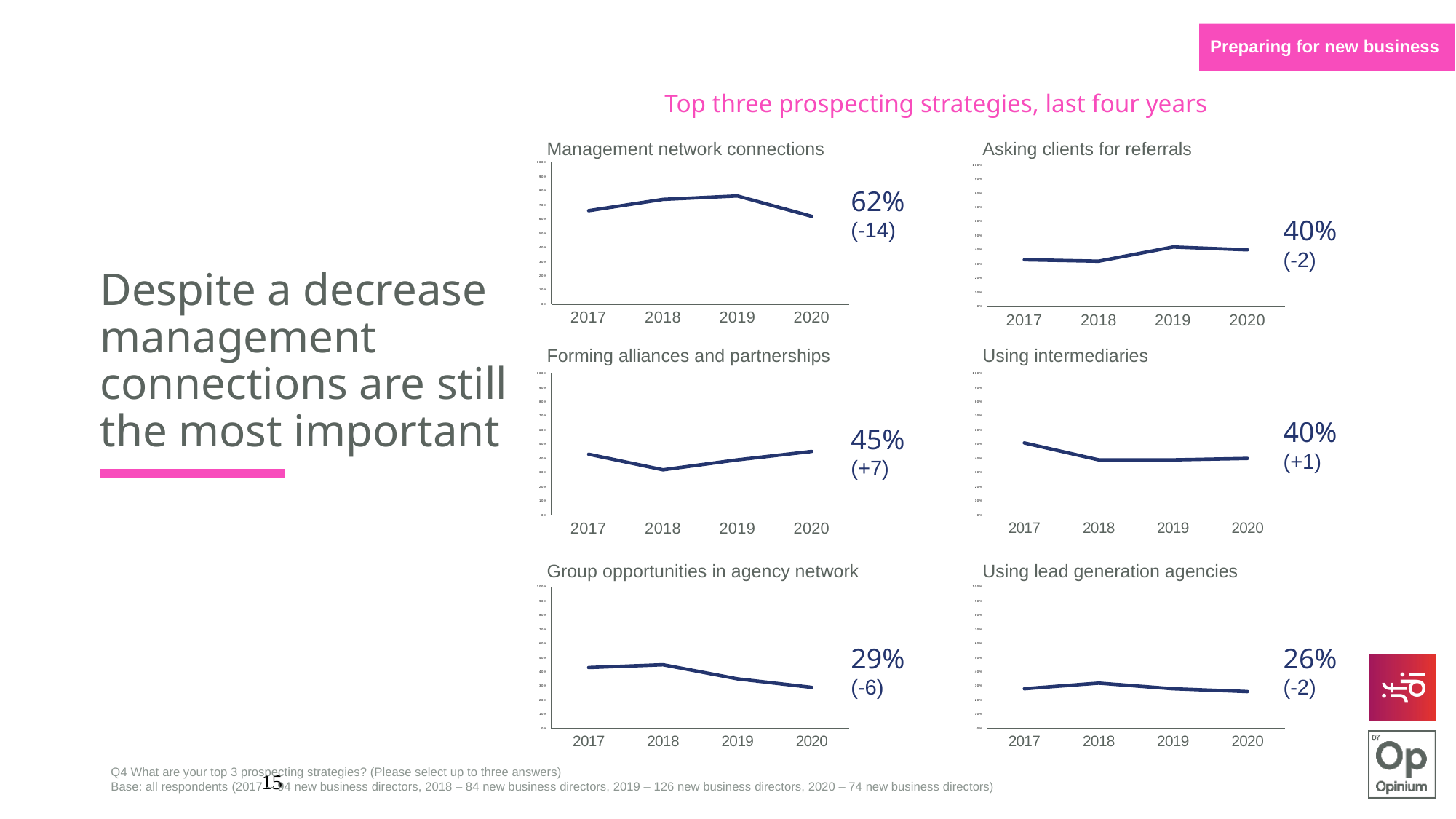
What type of chart is used for 'Group opportunities in agency network'? line chart In the 'Forming alliances and partnerships' chart, what change is shown in parentheses next to the 2020 value? (+7) Across the six charts, which strategy has the lowest 2020 value? Using lead generation agencies What is the difference between the 2020 value for 'Management network connections' and the 2020 value for 'Forming alliances and partnerships'? 17 percentage points In the 'Management network connections' chart, does the line rise or fall from 2019 to 2020? fall In the 'Forming alliances and partnerships' chart, does the line rise or fall from 2018 to 2020? rise How many years are plotted on the x axis of the 'Using intermediaries' chart? 4 In the 'Asking clients for referrals' chart, what is the value shown for 2020? 40% Across the six charts, which strategy has the highest 2020 value? Management network connections In the 'Management network connections' chart, what is the value shown for 2020? 62% In the 'Using lead generation agencies' chart, what is the value shown for 2020? 26% Which has a larger 2020 value: 'Group opportunities in agency network' or 'Using intermediaries'? Using intermediaries